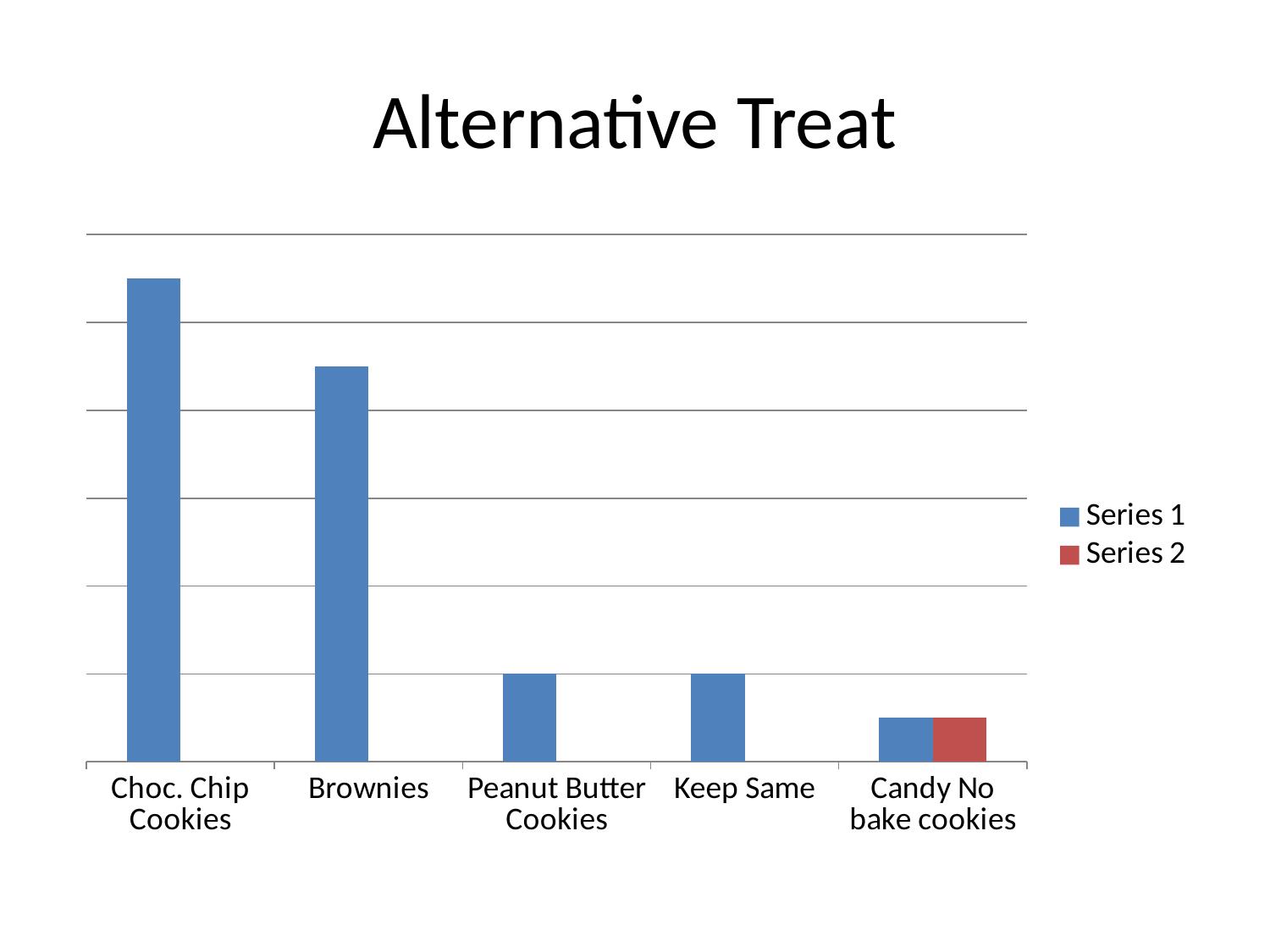
How many series does the legend list? 2 Which category is the only one with a visible Series 2 bar? Candy No bake cookies Which category has the highest Series 1 value? Choc. Chip Cookies What type of chart is shown on the slide? bar chart Which is larger for Series 1: Brownies or Peanut Butter Cookies? Brownies Which is larger for Series 1: Choc. Chip Cookies or Brownies? Choc. Chip Cookies Which is larger for Series 1: Keep Same or Candy No bake cookies? Keep Same How many categories are shown on the x axis of the chart? 5 Which category has the lowest Series 1 value? Candy No bake cookies What is the title of the chart? Alternative Treat